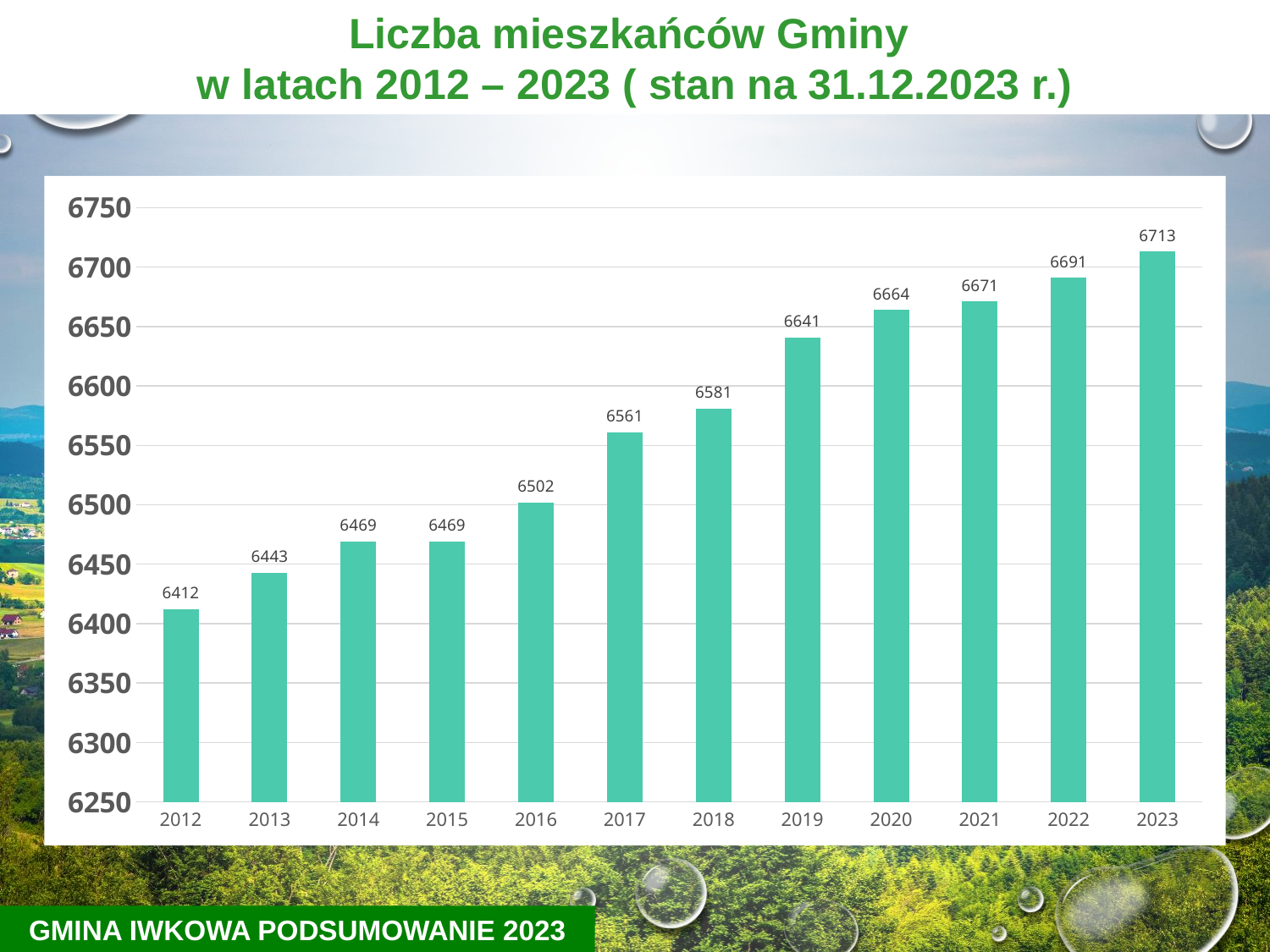
Which year has the lowest number of residents? 2012 What is the number of residents in 2019? 6641 What is the difference between the number of residents in 2017 and in 2016? 59 What is the difference between the number of residents in 2023 and in 2012? 301 Do the values rise or fall from 2012 to 2023? rise Is the value for 2015 greater or less than 6500? less What is the number of residents in 2023? 6713 Which year has the highest number of residents? 2023 Which year has more residents, 2018 or 2020? 2020 What kind of chart is shown on the slide? bar chart How many years are shown on the chart? 12 What is the number of residents in 2012? 6412